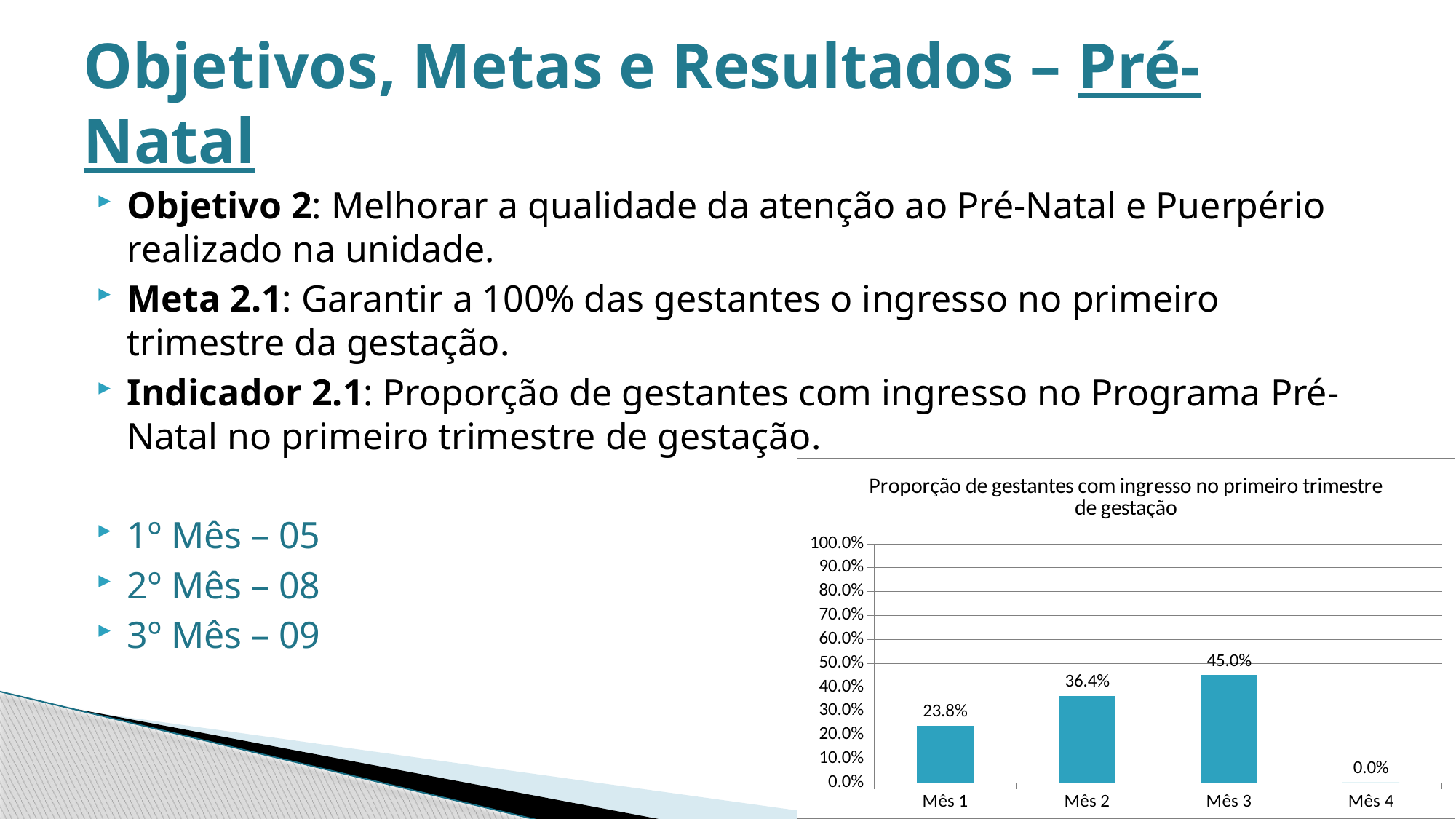
What is the value for Mês 1 in the chart? 23.8% What is the title of the chart? Proporção de gestantes com ingresso no primeiro trimestre de gestação What is the value for Mês 2 in the chart? 36.4% Which month has the highest value in the chart? Mês 3 Which is larger, the value for Mês 2 or the value for Mês 1? Mês 2 Is the value for Mês 3 greater or less than 50.0%? less How many categories are shown on the x axis of the chart? 4 What is the difference between the values for Mês 3 and Mês 1? 21.2% What kind of chart is shown on the slide? bar chart What is the value for Mês 3 in the chart? 45.0% What is the value for Mês 4 in the chart? 0.0% Which month has the lowest value in the chart? Mês 4